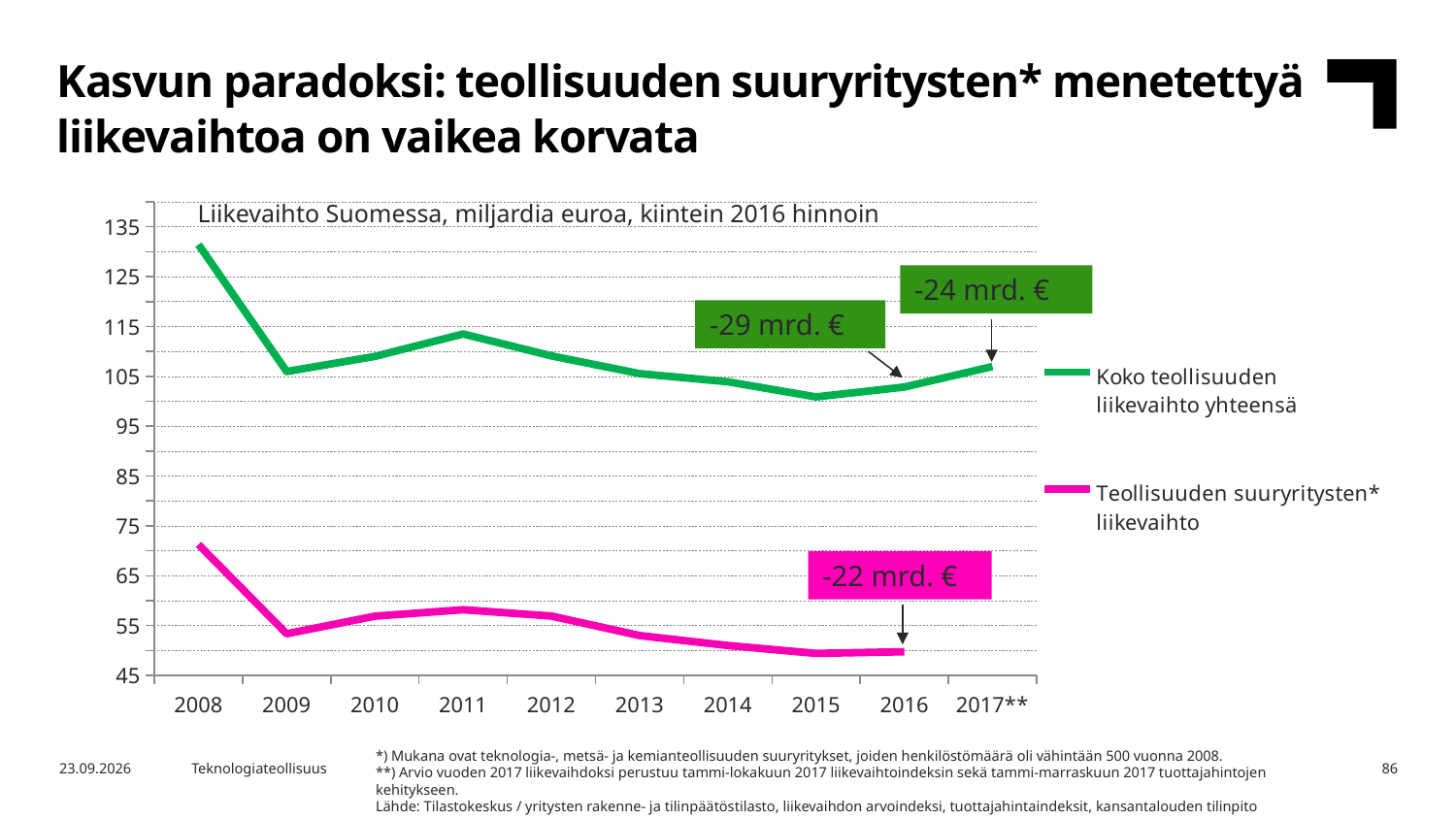
How many series does the legend list? 2 In which year is the Teollisuuden suuryritysten* liikevaihto series at its highest? 2008 What value is annotated for the Koko teollisuuden liikevaihto yhteensä series at 2016? -29 mrd. € What is the title of the chart? Liikevaihto Suomessa, miljardia euroa, kiintein 2016 hinnoin What value is annotated for the Teollisuuden suuryritysten* liikevaihto series at 2016? -22 mrd. € Is the value for Koko teollisuuden liikevaihto yhteensä in 2008 greater or less than 125? greater What value is annotated for the Koko teollisuuden liikevaihto yhteensä series at 2017**? -24 mrd. € What kind of chart is shown on the slide? line chart How many years are shown on the x axis? 10 Is the value for Teollisuuden suuryritysten* liikevaihto in 2015 greater or less than 55? less Does the Koko teollisuuden liikevaihto yhteensä series rise or fall from 2008 to 2009? fall In which year is the Koko teollisuuden liikevaihto yhteensä series at its highest? 2008